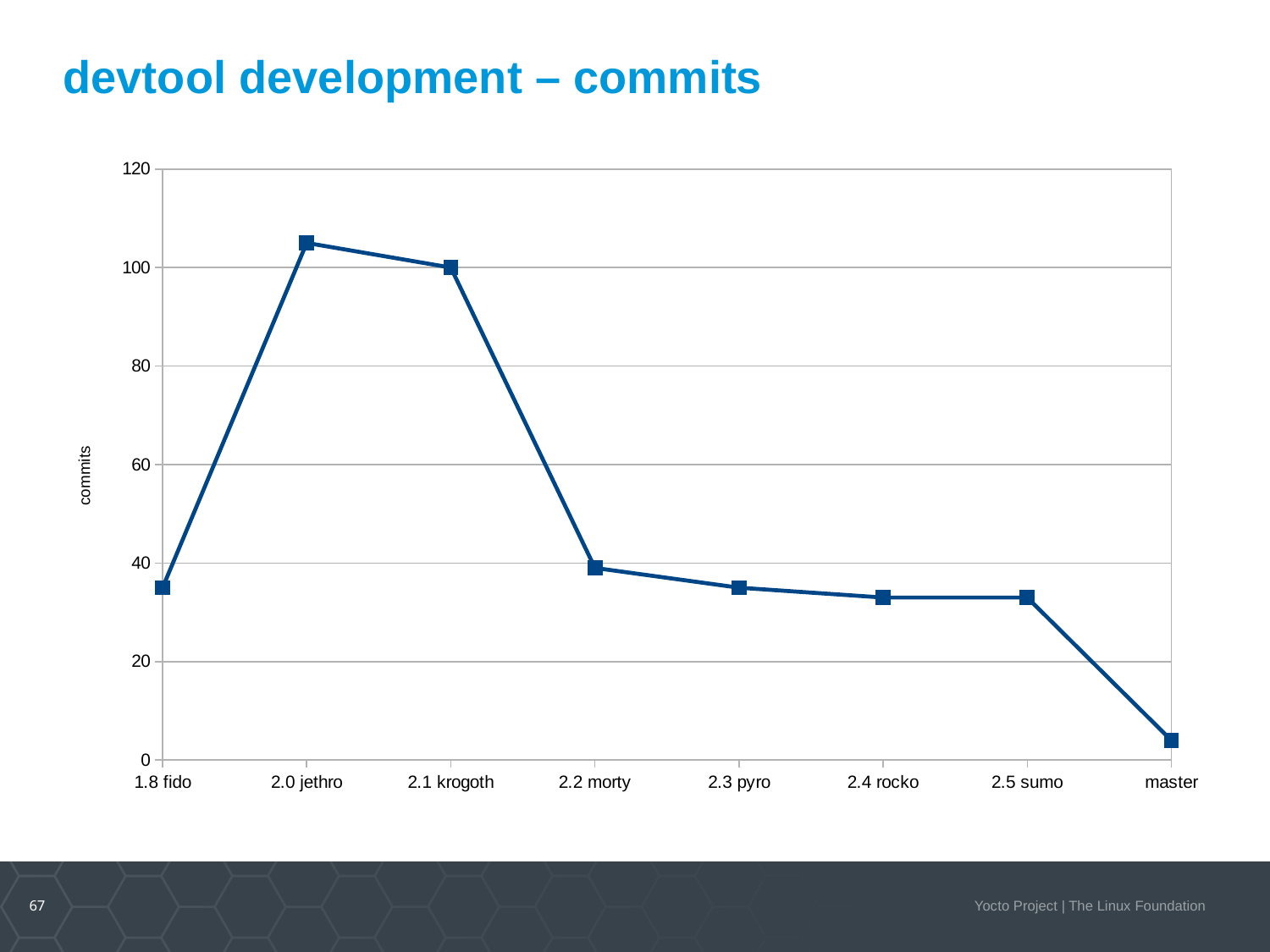
Which has more commits, 1.8 fido or 2.0 jethro? 2.0 jethro What kind of chart is shown on the slide? line chart What is the label on the vertical axis? commits Do the commit values rise or fall from 2.1 krogoth to master? fall Which release has the highest number of commits? 2.0 jethro How many commits are shown for 2.1 krogoth? 100 Which release has the lowest number of commits? master Is the value for 2.4 rocko greater or less than 40? less Is the value for 1.8 fido greater or less than 40? less Is the value for master greater or less than 20? less How many release points are plotted on the chart? 8